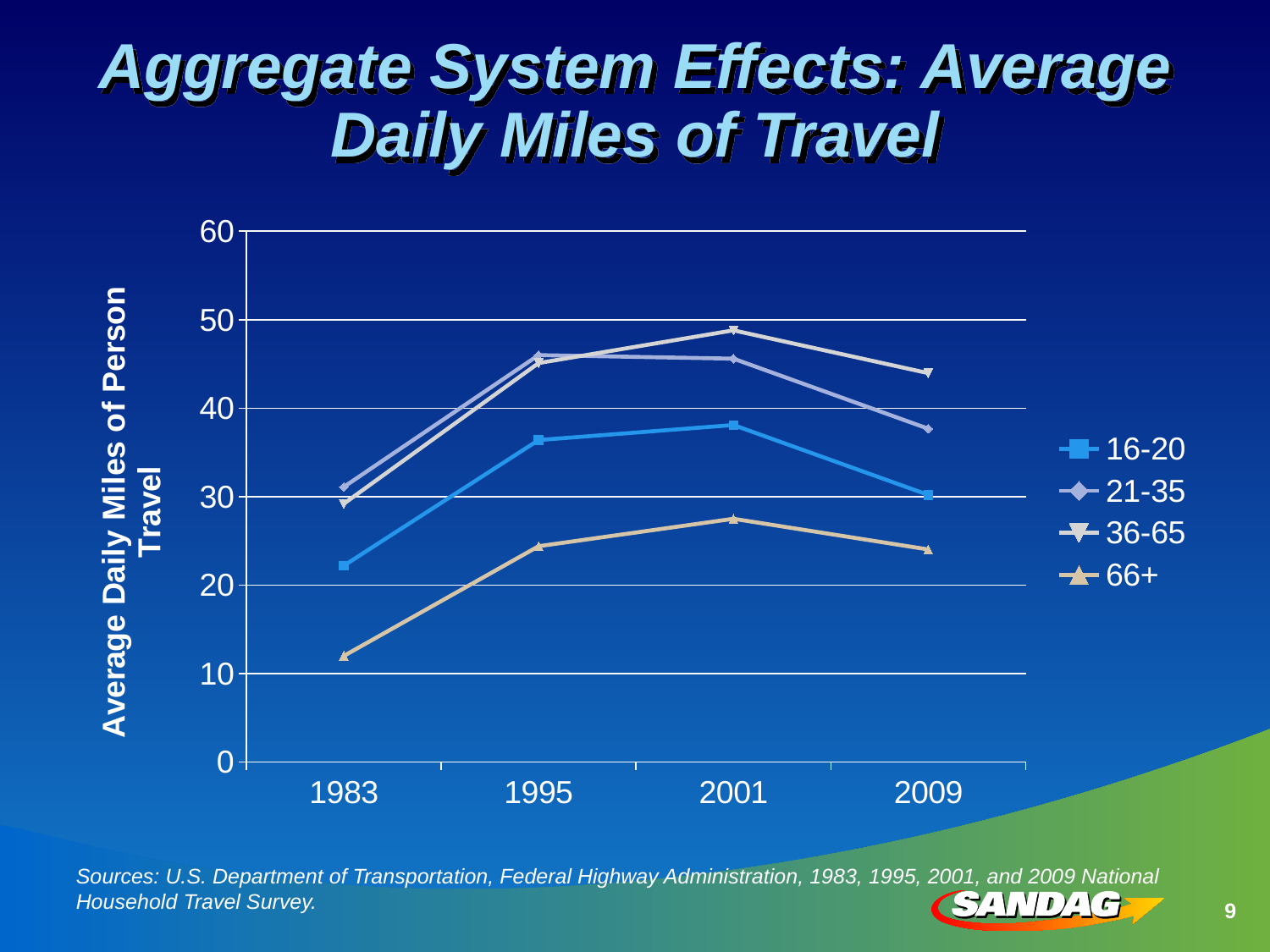
How many series does the legend list? 4 Which age group has the highest average daily miles of travel in 2001? 36-65 How many years are shown along the x axis? 4 Does the value for the 16-20 group rise or fall from 2001 to 2009? fall In which year does the 36-65 group reach its highest value? 2001 What kind of chart is shown on the slide? line chart What is the title of the y axis? Average Daily Miles of Person Travel In 2009, which group has the larger value: 21-35 or 36-65? 36-65 Which age group has the lowest average daily miles of travel in 2009? 66+ Is the value for the 66+ group in 1983 greater or less than 20? less Is the value for the 16-20 group in 2001 greater or less than 40? less Is the value for the 36-65 group in 2001 greater or less than 40? greater